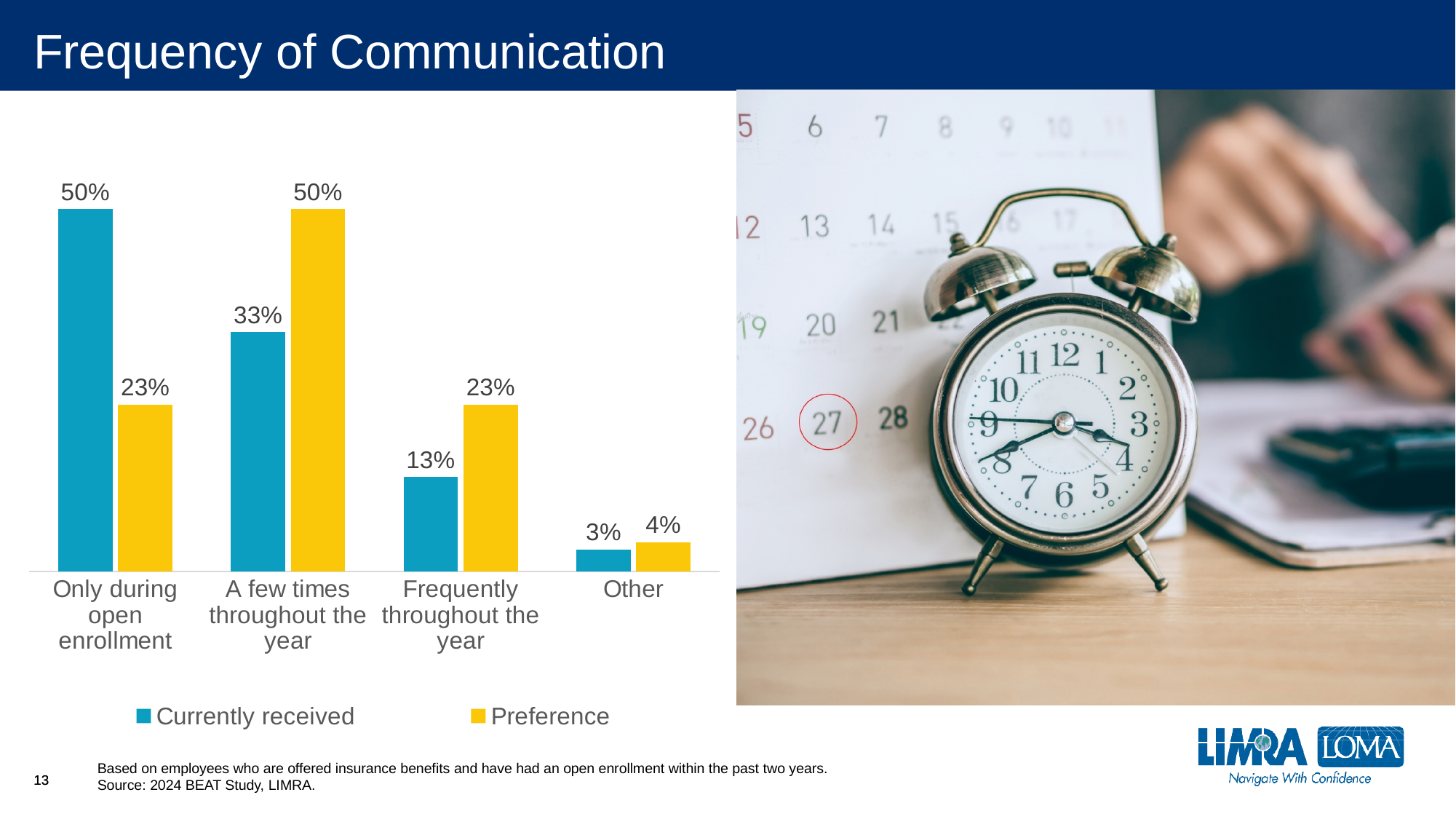
What is the 'Preference' value for 'Other'? 4% How many categories are shown on the x axis? 4 What is the 'Preference' value for 'A few times throughout the year'? 50% How many series does the legend list? 2 What is the difference between the 'Currently received' and 'Preference' values for 'Only during open enrollment'? 27% Which category has the lowest 'Currently received' value? Other What kind of chart is shown on the slide? Bar chart What is the 'Currently received' value for 'Only during open enrollment'? 50% Which colour represents the 'Preference' series? Yellow Which category has the highest 'Preference' value? A few times throughout the year What is the 'Currently received' value for 'Frequently throughout the year'? 13% For 'Frequently throughout the year', which is larger: 'Currently received' or 'Preference'? Preference